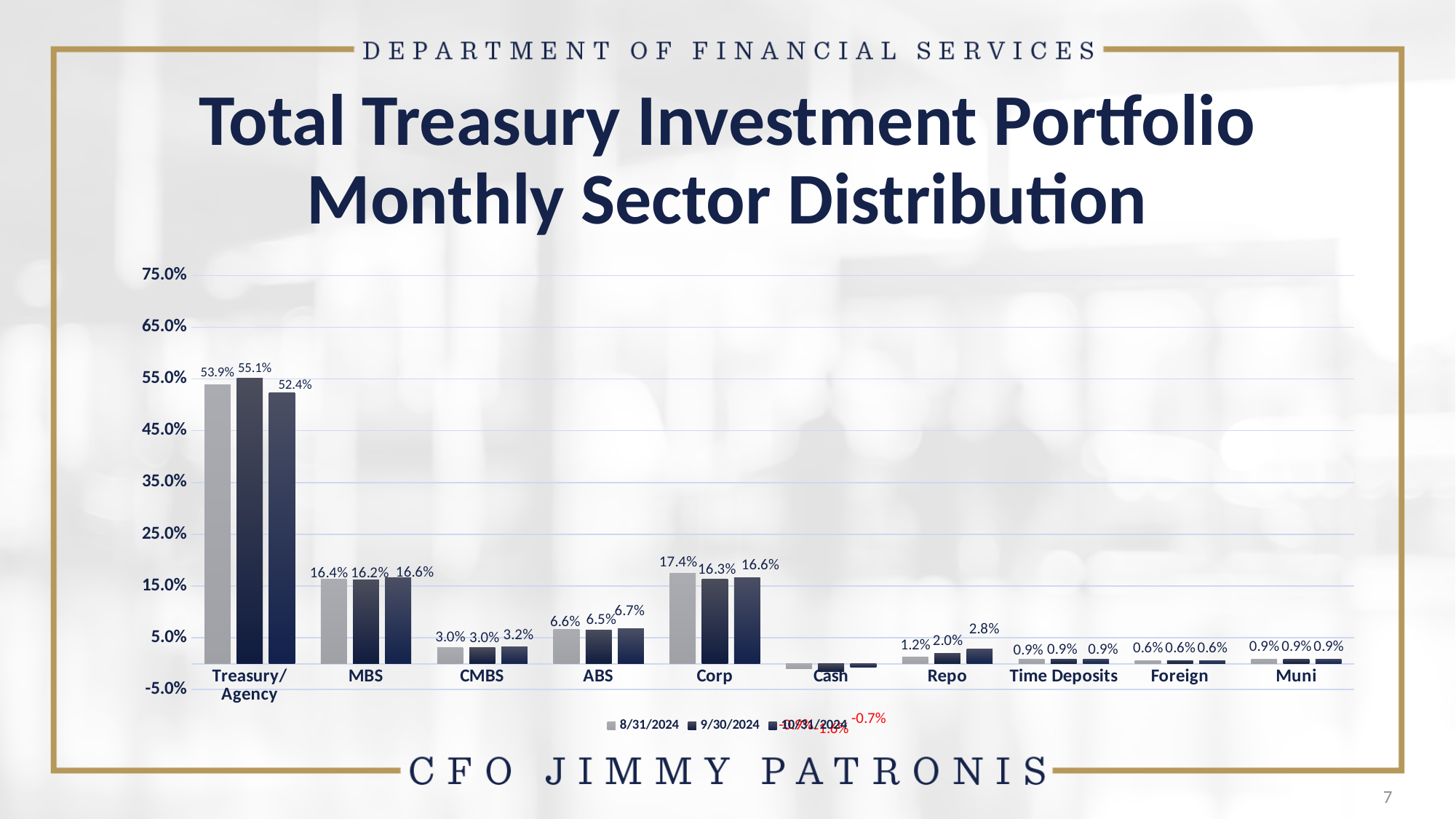
Which sector has the highest value in the 10/31/2024 series? Treasury/Agency How many series does the legend list? 3 How many sector categories are shown on the x axis? 10 What is the value for Repo in the 10/31/2024 series? 2.8% What is the value for Treasury/Agency in the 9/30/2024 series? 55.1% What is the title of the chart? Total Treasury Investment Portfolio Monthly Sector Distribution Do the Repo values rise or fall from 8/31/2024 to 10/31/2024? rise Which is larger for MBS: the 8/31/2024 value or the 10/31/2024 value? 10/31/2024 What is the value for ABS in the 10/31/2024 series? 6.7% What is the value for Corp in the 8/31/2024 series? 17.4% What is the difference between the 9/30/2024 and 10/31/2024 values for Treasury/Agency? 2.7% What kind of chart is shown on the slide? bar chart